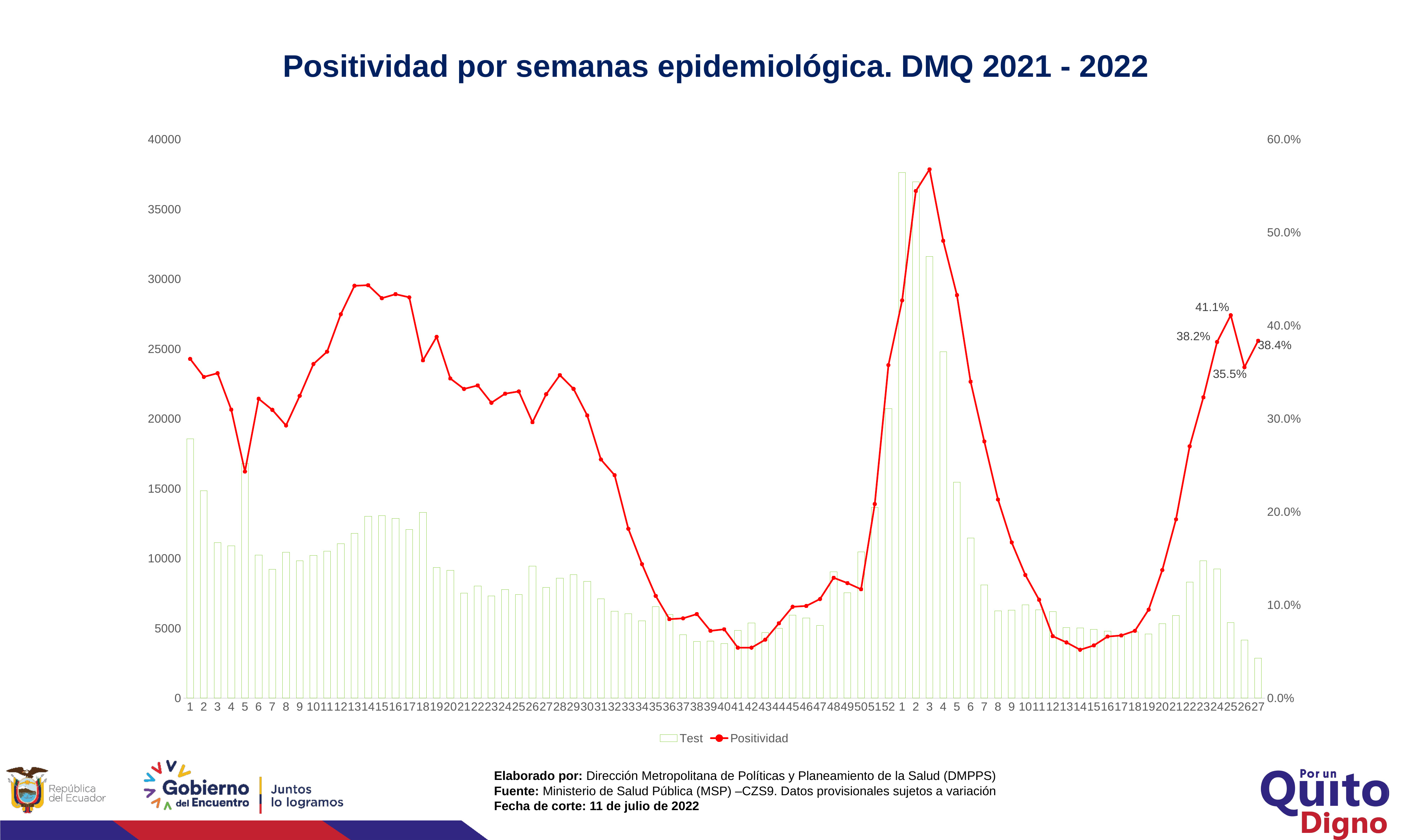
Is the Positividad value at week 41 of 2021 greater or less than 10.0%? less What are the two series named in the legend? Test and Positividad What is the Positividad value labelled at week 24 of 2022? 38.2% What is the Positividad value labelled at week 27 of 2022, the last point on the chart? 38.4% What is the Positividad value labelled at week 26 of 2022? 35.5% Which is larger, the labelled Positividad at week 24 of 2022 or at week 27 of 2022? Week 27 of 2022 (38.4%) How many series does the legend list? 2 Which week has the highest Positividad value on the chart? Week 3 of 2022 What is the difference in percentage points between the labelled Positividad values at week 25 (41.1%) and week 26 (35.5%) of 2022? 5.6 percentage points What kind of chart is shown on the slide? A combined bar and line chart What is the Positividad value labelled at week 25 of 2022? 41.1% Is the number of Test at week 1 of 2022 greater or less than 35000? greater